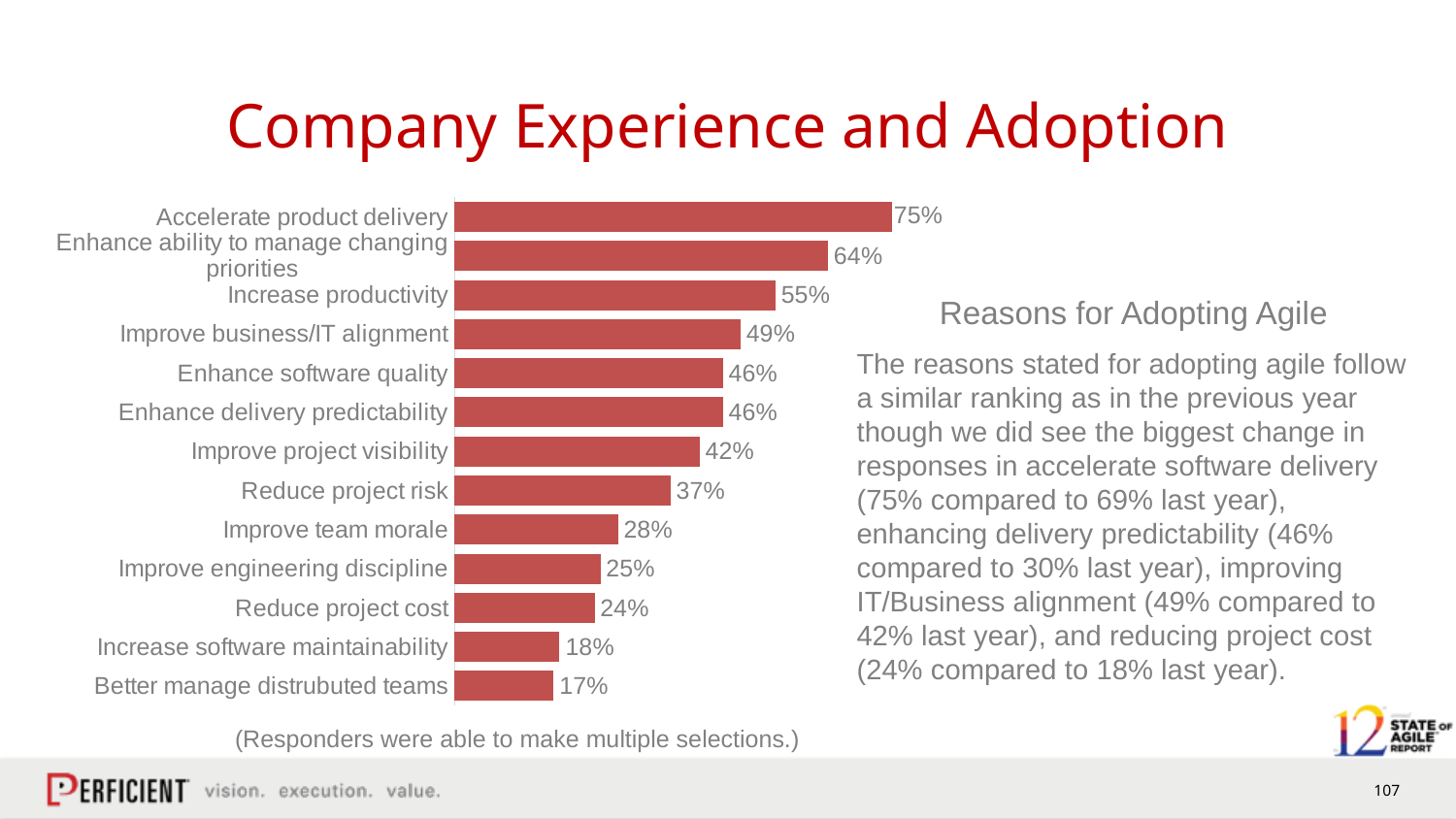
What colour are the bars in the chart? Red What type of chart is shown on the slide? Bar chart What is the difference between the values for "Increase productivity" and "Improve project visibility"? 13% How many categories are shown in the bar chart? 13 Which category has the highest value in the chart? Accelerate product delivery Which has a larger value, "Improve business/IT alignment" or "Reduce project cost"? Improve business/IT alignment What is the difference between the values for "Accelerate product delivery" and "Enhance ability to manage changing priorities"? 11% What percentage of respondents selected "Accelerate product delivery"? 75% What is the value shown for "Improve team morale"? 28% What is the value shown for "Reduce project risk"? 37% Which category has the lowest value in the chart? Better manage distrubuted teams Which has a larger value, "Improve engineering discipline" or "Increase software maintainability"? Improve engineering discipline